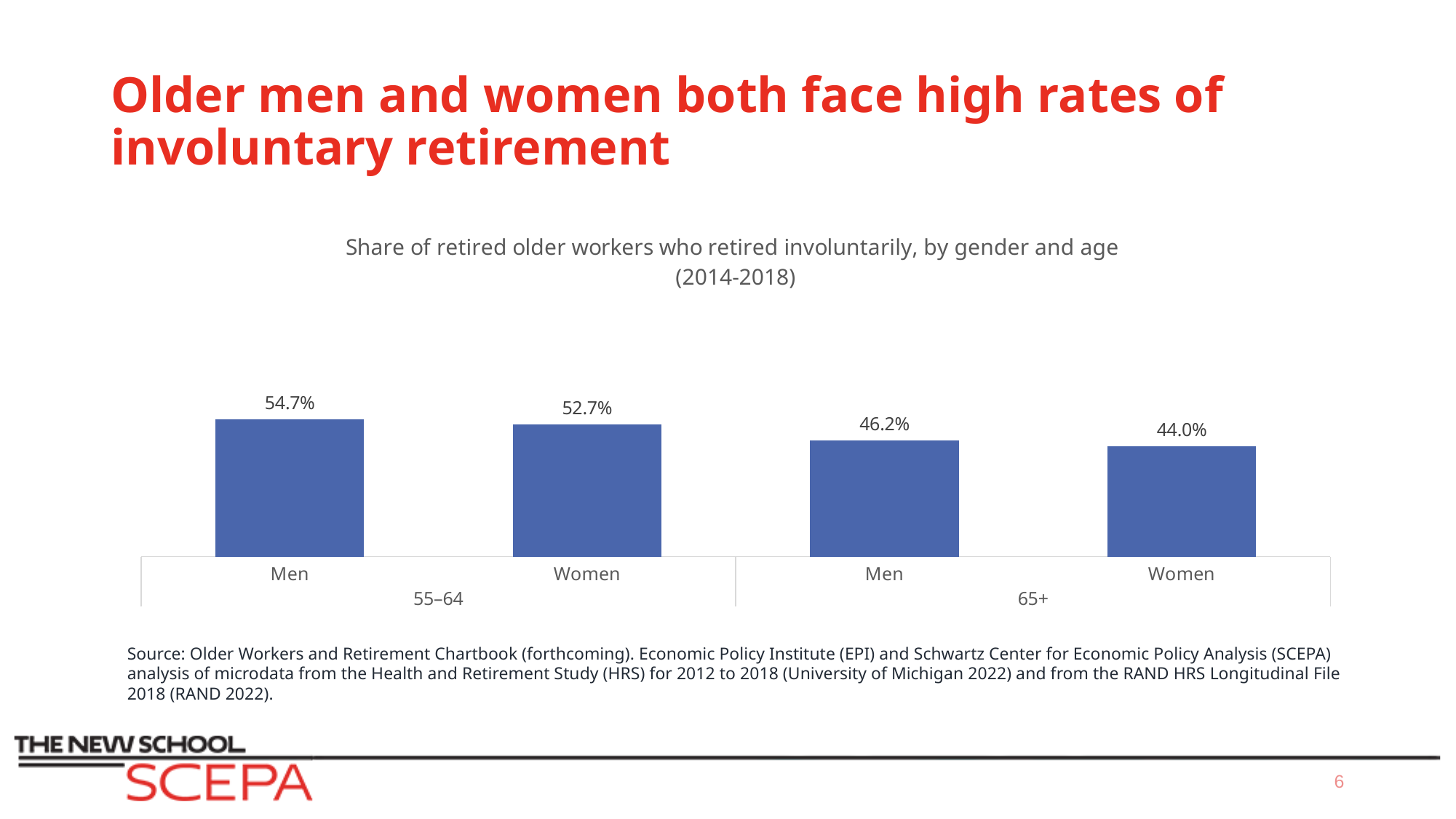
What is the difference in percentage points between men aged 55–64 and men aged 65+? 8.5 percentage points Which is larger: the share for women aged 55–64 or the share for men aged 65+? Women aged 55–64 What type of chart is shown on the slide? Bar chart What share of retired women aged 55–64 retired involuntarily? 52.7% How many bars are shown in the chart? 4 What is the title of the chart? Share of retired older workers who retired involuntarily, by gender and age (2014-2018) What share of retired women aged 65+ retired involuntarily? 44.0% What share of retired men aged 65+ retired involuntarily? 46.2% What is the difference in percentage points between men and women aged 65+? 2.2 percentage points What share of retired men aged 55–64 retired involuntarily? 54.7% Which group has the lowest share of involuntary retirement? Women, 65+ Which group has the highest share of involuntary retirement? Men, 55–64